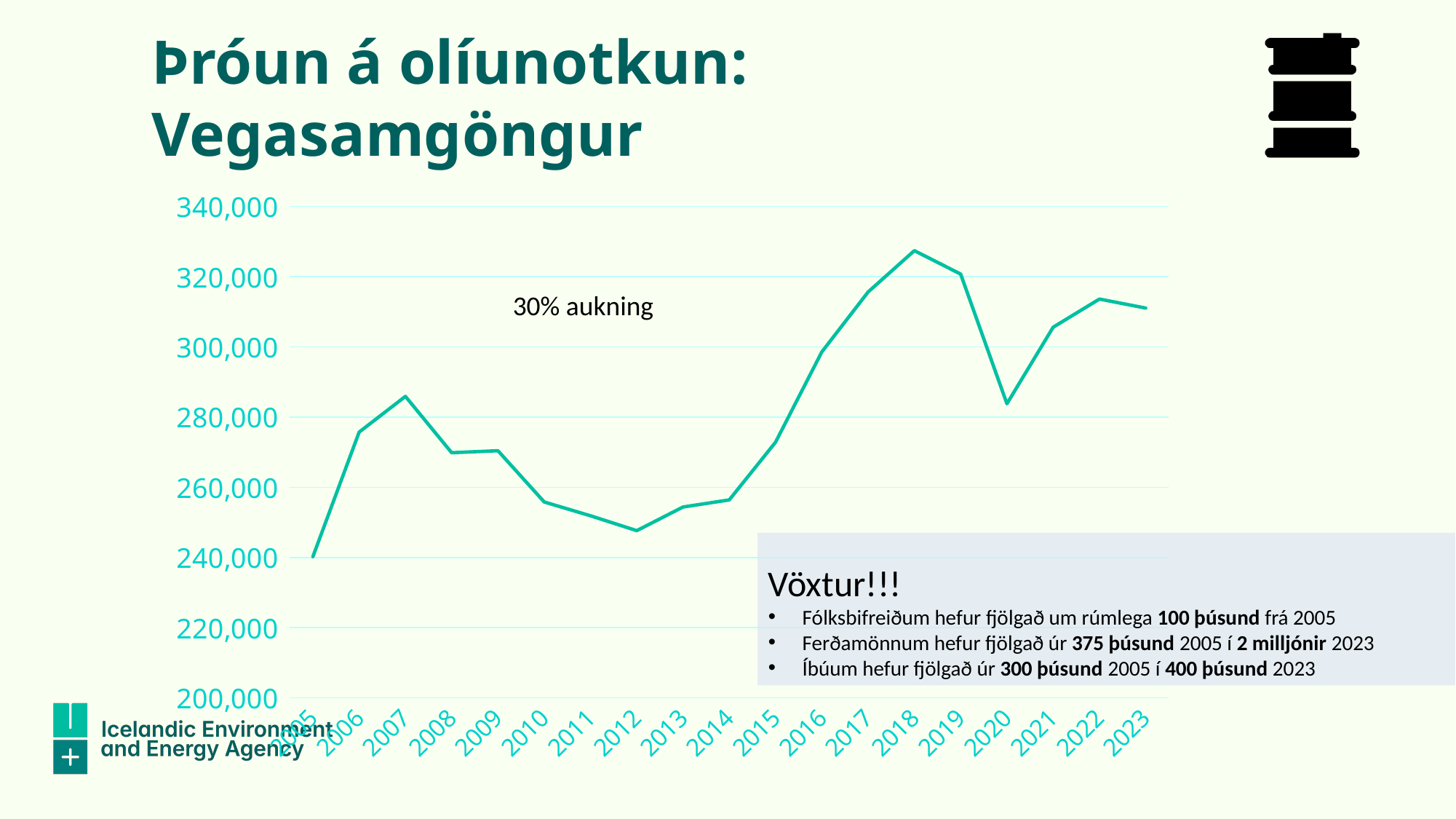
Which year has the lowest value on the chart? 2005 Do the values rise or fall from 2012 to 2018? rise Which year has the larger value, 2007 or 2018? 2018 What annotation text is printed above the line in the chart? 30% aukning Is the value for 2018 greater or less than 320,000? greater How many years are plotted along the x axis of the chart? 19 Which year has the larger value, 2019 or 2020? 2019 Is the value for 2023 greater or less than 300,000? greater Is the value for 2020 greater or less than 300,000? less What kind of chart is shown on the slide? line chart Which year has the highest value on the chart? 2018